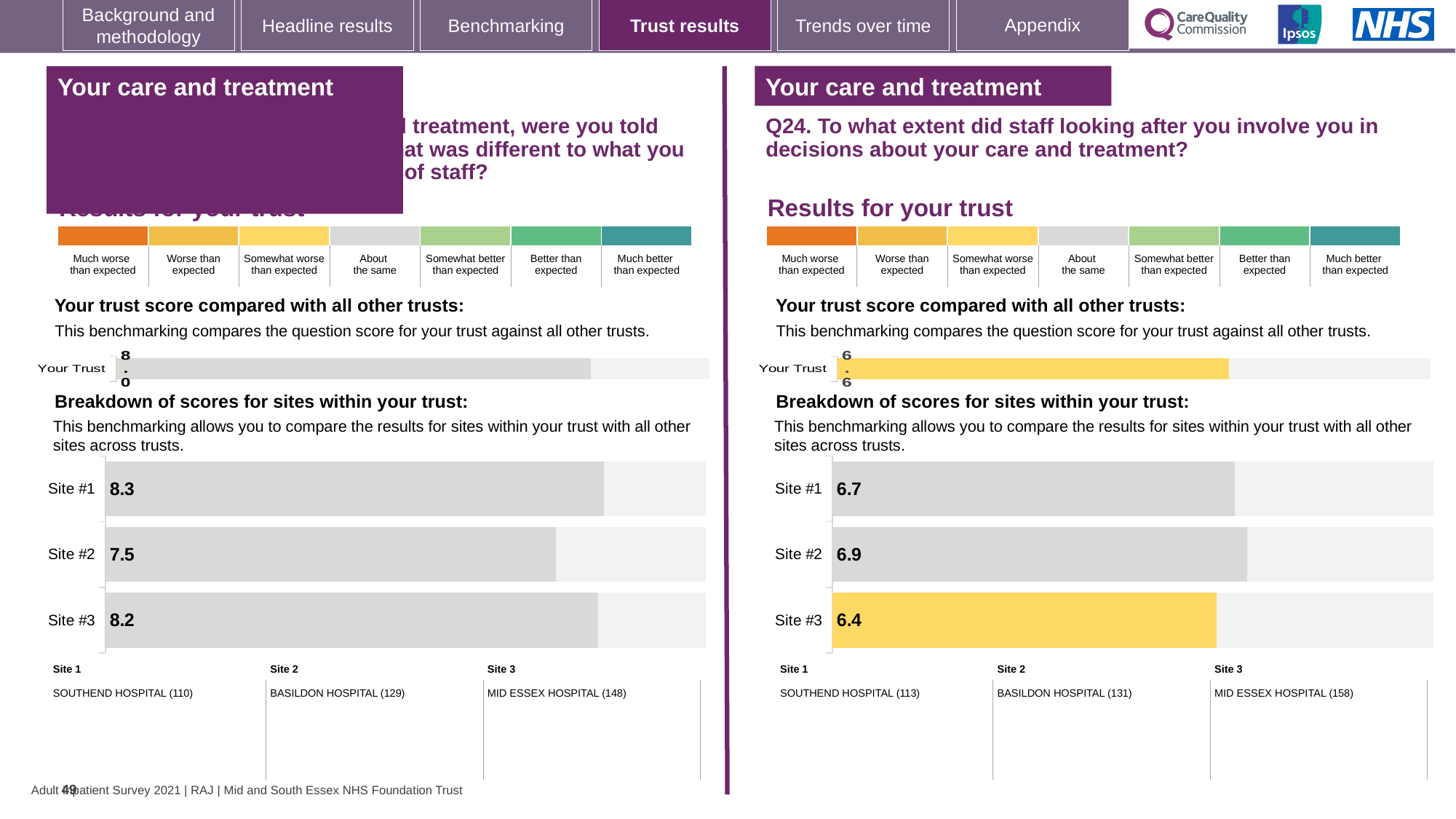
On the left-hand chart, which has the larger score, Site #1 or Site #3? Site #1 On the left-hand chart, what is the difference between the scores for Site #1 and Site #2? 0.8 On the right-hand chart (Q24), what is the score for Site #1? 6.7 What type of chart is used for the breakdown of scores for sites on the right-hand side (Q24)? Bar chart On the left-hand chart, what is the score for Site #1? 8.3 On the left-hand chart, what is the score for Site #2? 7.5 How many sites are shown in the site breakdown chart on the right-hand side (Q24)? 3 On the right-hand chart (Q24), which site's bar is coloured yellow rather than grey? Site #3 On the right-hand chart (Q24), which site has the highest score? Site #2 On the left-hand chart, which site has the lowest score? Site #2 On the right-hand chart (Q24), what is the difference between the scores for Site #2 and Site #3? 0.5 On the right-hand chart (Q24), what is the score for Site #3? 6.4